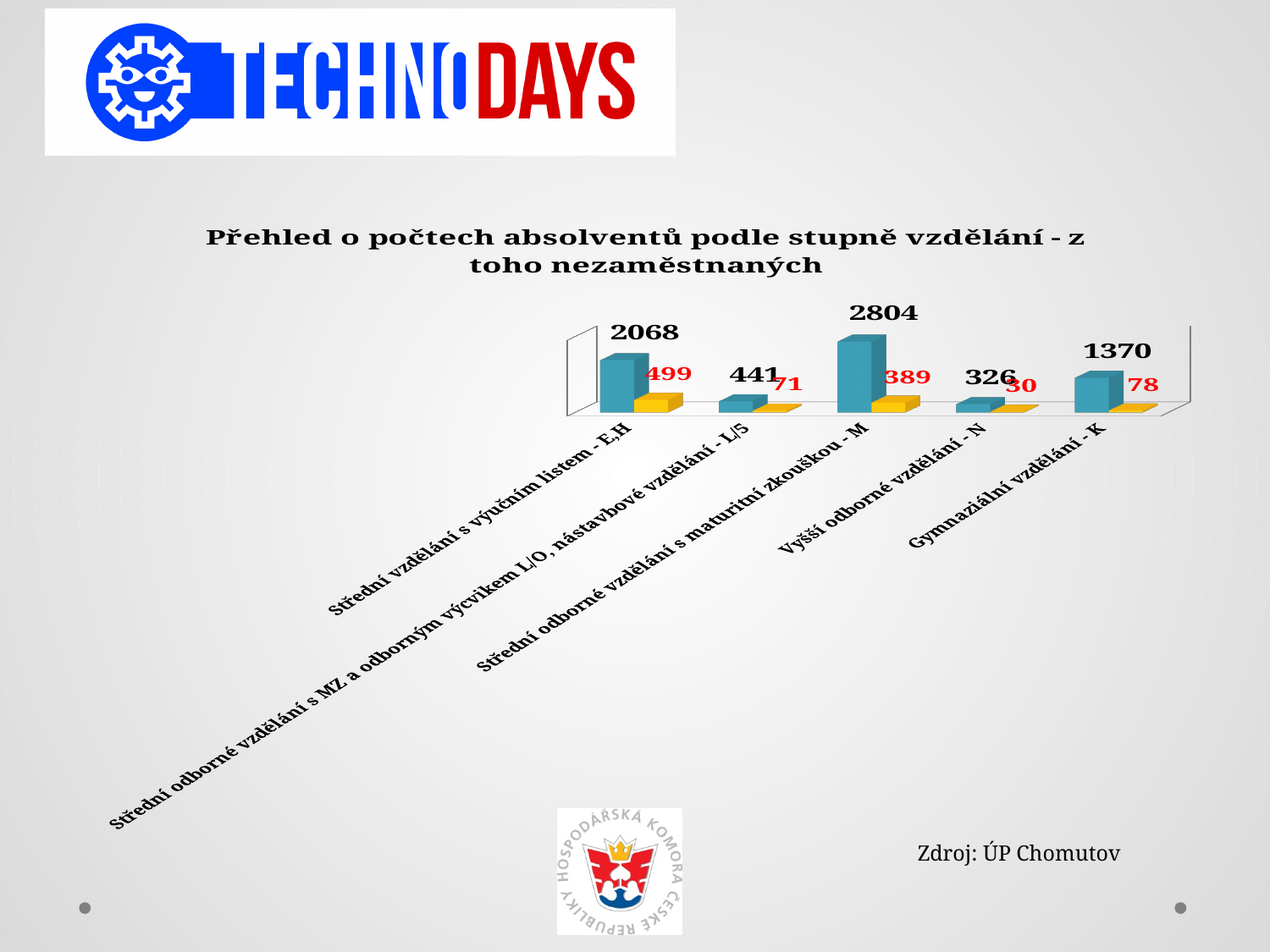
Which category has the highest blue bar value? Střední odborné vzdělání s maturitní zkouškou - M What is the value of the blue bar for 'Gymnaziální vzdělání - K'? 1370 What is the red-labelled (unemployed) value for 'Vyšší odborné vzdělání - N'? 30 What type of chart is shown on the slide? bar chart Which has a larger red-labelled (unemployed) value: 'Střední vzdělání s výučním listem - E,H' or 'Střední odborné vzdělání s maturitní zkouškou - M'? Střední vzdělání s výučním listem - E,H What is the red-labelled (unemployed) value for 'Střední vzdělání s výučním listem - E,H'? 499 What is the value of the blue bar for 'Střední odborné vzdělání s maturitní zkouškou - M'? 2804 What is the difference between the blue bar values for 'Střední odborné vzdělání s maturitní zkouškou - M' and 'Střední vzdělání s výučním listem - E,H'? 736 What is the title of the chart? Přehled o počtech absolventů podle stupně vzdělání - z toho nezaměstnaných Which category has the lowest blue bar value? Vyšší odborné vzdělání - N How many categories are shown on the x axis of the chart? 5 What is the difference between the blue bar value and the red-labelled value for 'Gymnaziální vzdělání - K'? 1292